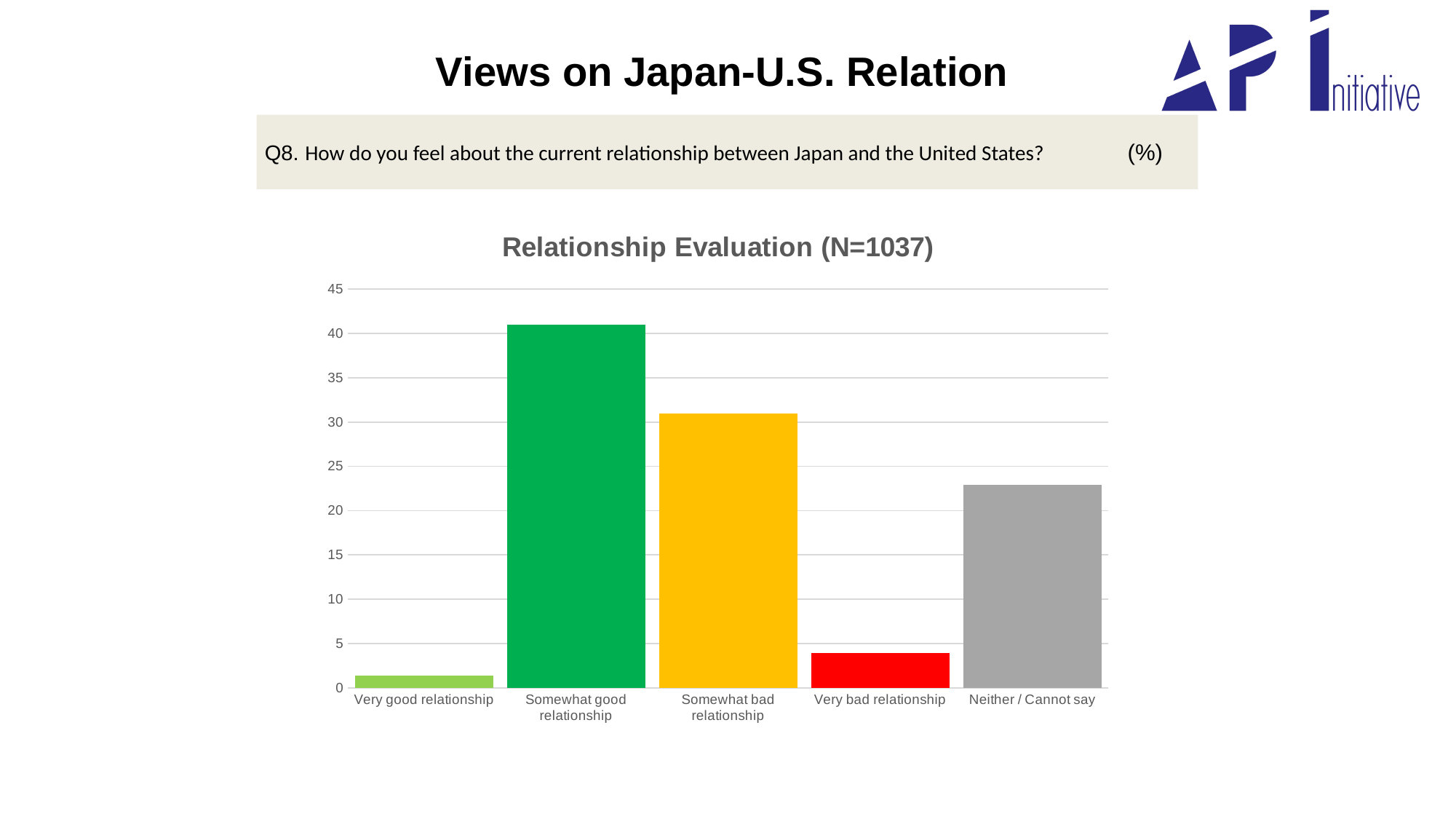
Is the value for Somewhat bad relationship greater or less than 25? greater Is the value for Somewhat good relationship greater or less than 35? greater Which is larger, the value for Somewhat bad relationship or the value for Neither / Cannot say? Somewhat bad relationship Which category has the highest value in the chart? Somewhat good relationship What colour is the bar for Very bad relationship? red What is the title of the chart? Relationship Evaluation (N=1037) Which category has the lowest value in the chart? Very good relationship How many categories are shown on the x axis of the chart? 5 What kind of chart is shown on the slide? bar chart Is the value for Neither / Cannot say greater or less than 20? greater Which is larger, the value for Very bad relationship or the value for Very good relationship? Very bad relationship